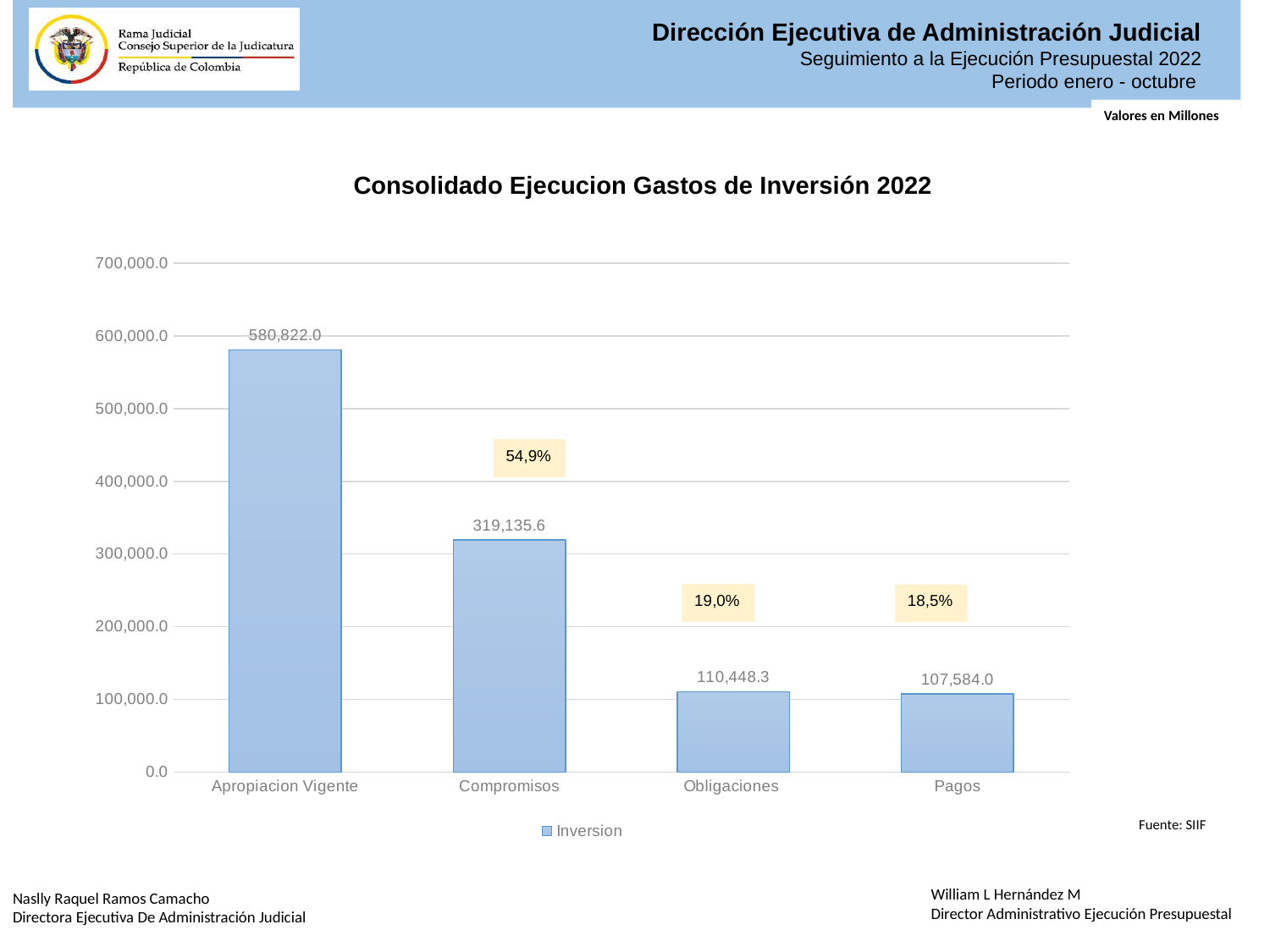
What percentage label is shown above the Pagos bar? 18,5% What percentage label is shown above the Compromisos bar? 54,9% Which is larger, Obligaciones or Pagos? Obligaciones What is the value for Apropiacion Vigente? 580,822.0 What is the value for Pagos? 107,584.0 How many categories are shown on the x axis? 4 What kind of chart is this? Bar chart What is the value for Obligaciones? 110,448.3 What is the value for Compromisos? 319,135.6 What is the difference between Apropiacion Vigente and Compromisos? 261,686.4 Which category has the lowest value? Pagos Which category has the highest value? Apropiacion Vigente